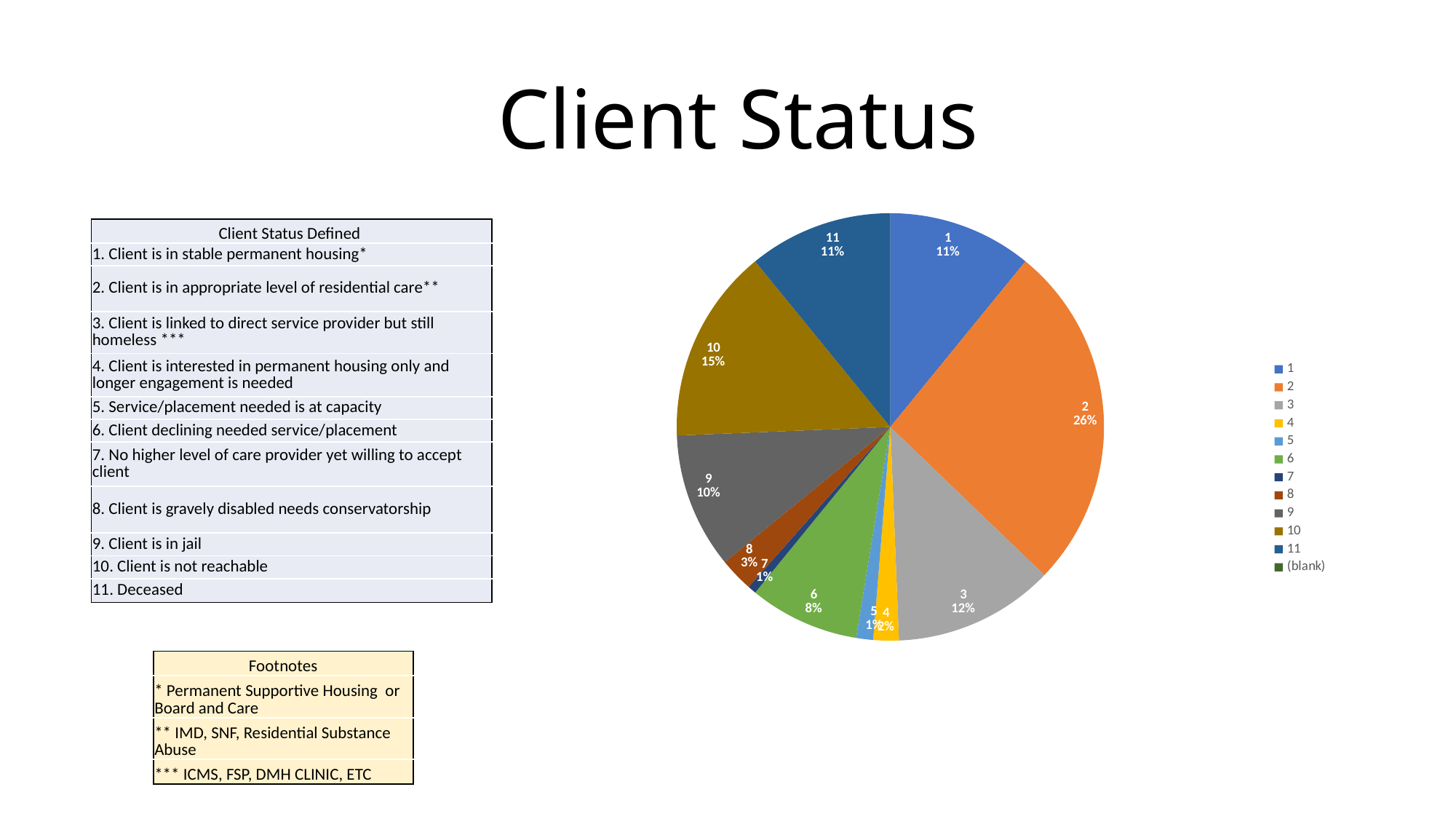
What is the title of the slide containing the chart? Client Status What kind of chart is shown on the slide? Pie chart How many entries does the legend list? 12 What percentage is shown for category 6? 8% What percentage is shown for category 9? 10% What share of the pie does category 2 represent? 26% What percentage is shown for category 3? 12% What percentage is shown for category 8? 3% What is the difference in percentage points between category 2 and category 3? 14% Which has a larger share, category 10 or category 9? 10 What percentage is shown for category 10? 15% Which category has the largest slice of the pie? 2